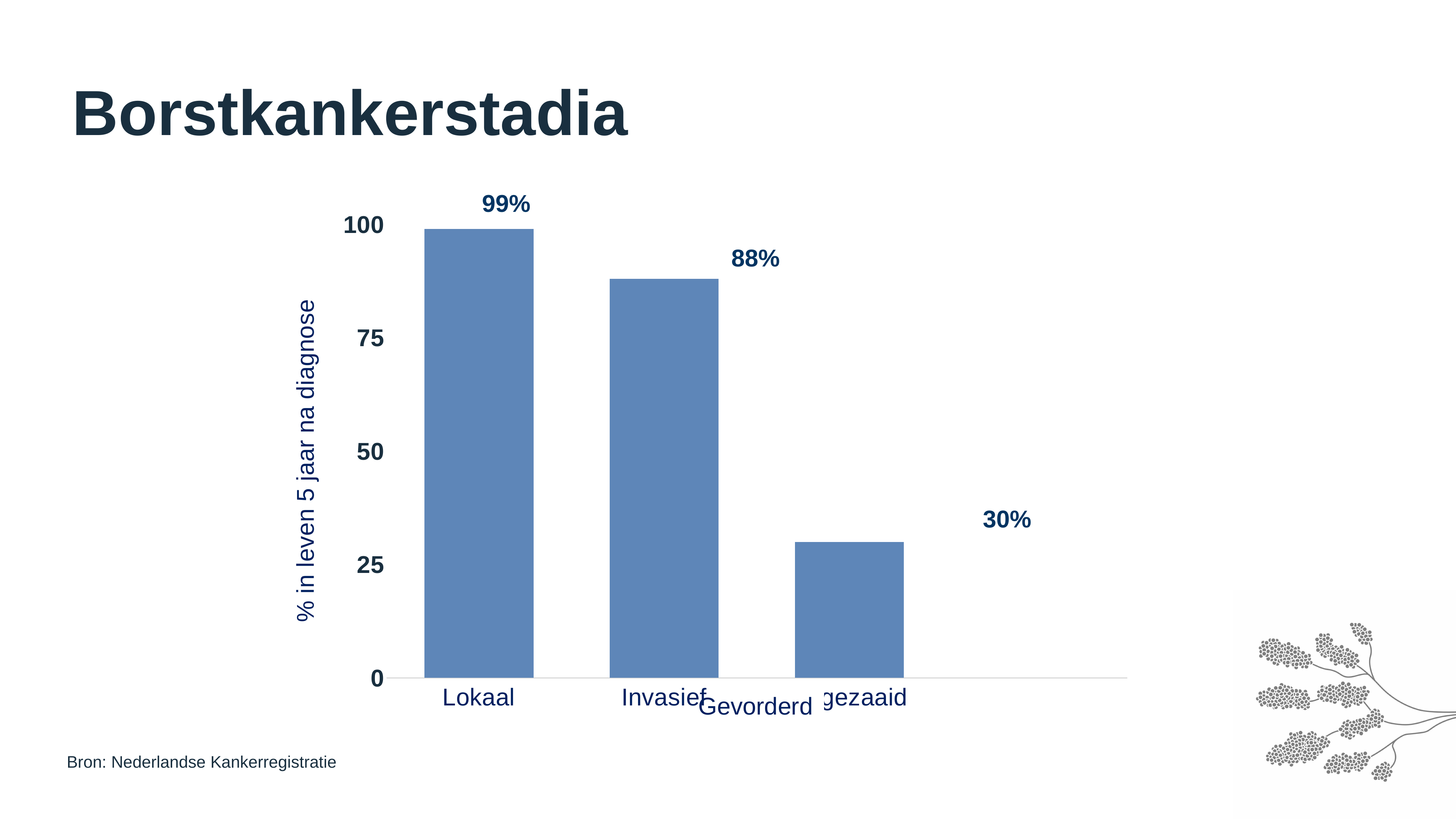
What is the value for Lokaal? 99% What is the title of the vertical axis? % in leven 5 jaar na diagnose What is the value for the third bar (Gevorderd)? 30% What is the difference between the values for Lokaal and Invasief? 11% What kind of chart is shown on the slide? bar chart How many bars are shown in the chart? 3 What is the value for Invasief? 88% Which is larger, the value for Lokaal or the value for Invasief? Lokaal Which category has the highest value? Lokaal